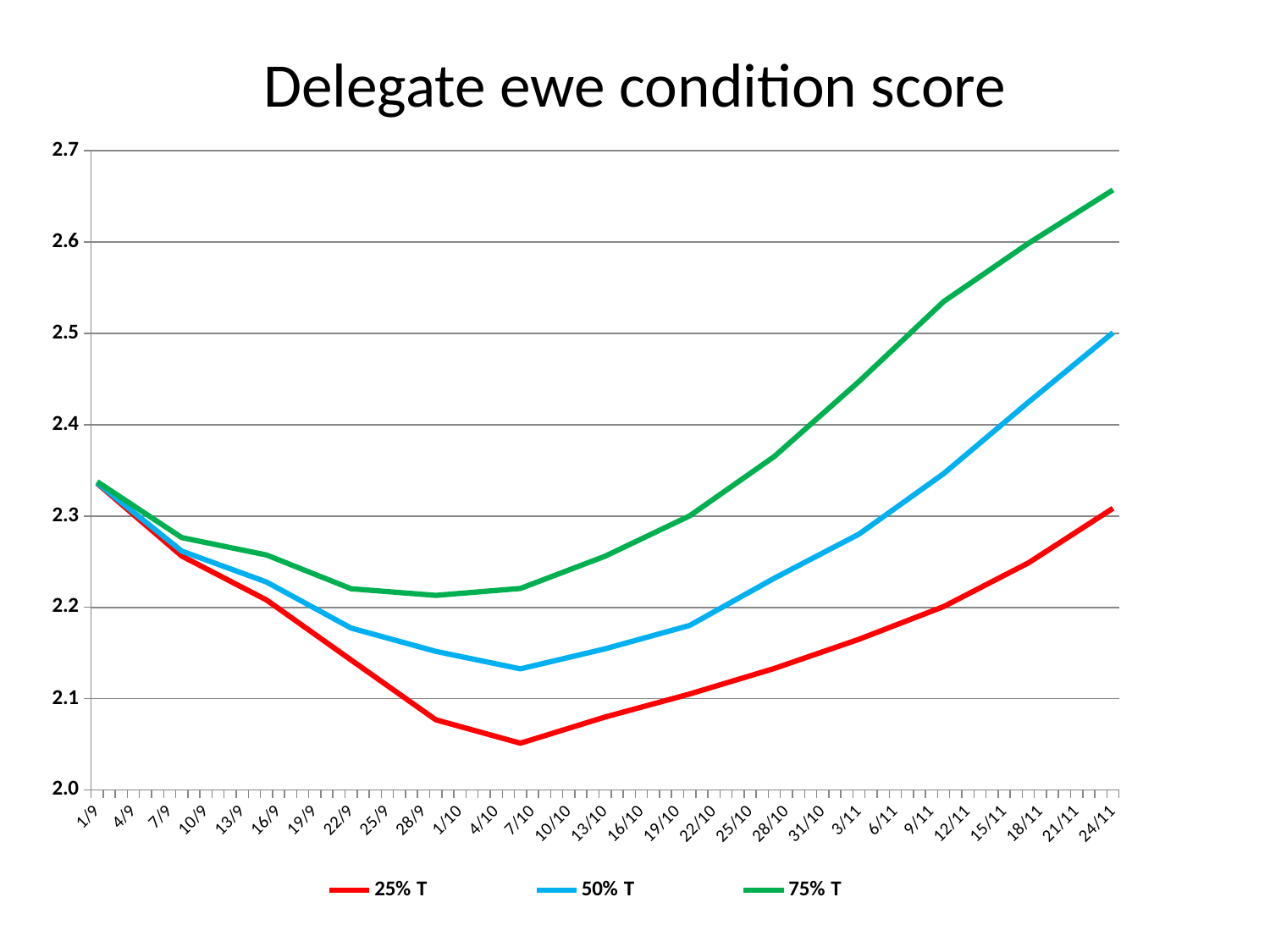
At 24/11, which is larger: the value for 75% T or the value for 25% T? 75% T Is the value for 75% T at 24/11 greater or less than 2.6? greater Which series has the highest value at 24/11? 75% T Which series is drawn in green? 75% T Does the 25% T series rise or fall from 7/10 to 24/11? rise How many series does the legend list? 3 What is the title of the chart? Delegate ewe condition score Is the value for 50% T at 7/10 greater or less than 2.1? greater Which series has the lowest value at 7/10? 25% T Is the value for 25% T at 7/10 greater or less than 2.1? less What kind of chart is shown on the slide? line chart